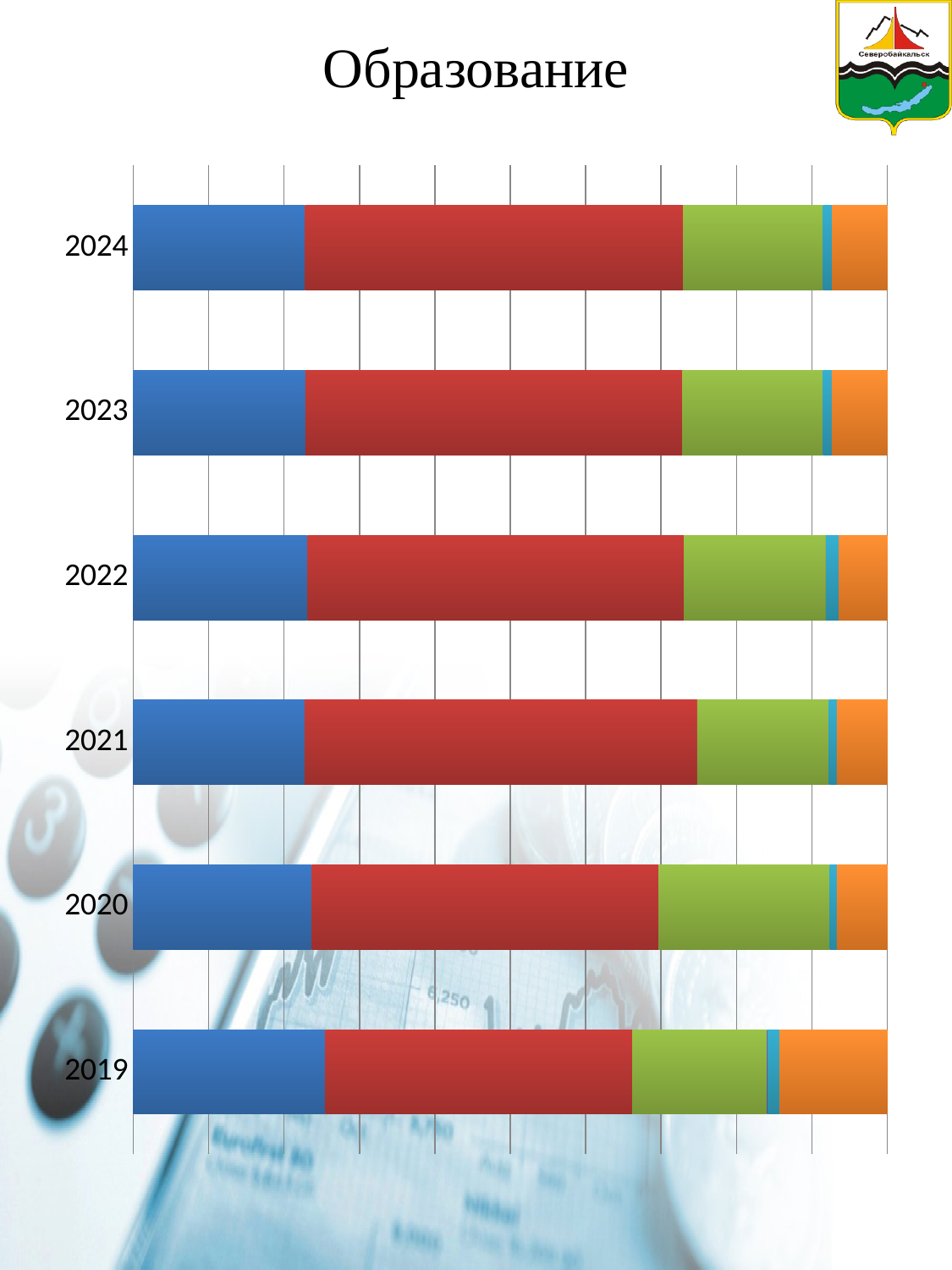
Which year is listed at the bottom of the chart? 2019 How many coloured segments make up each bar in the chart? 5 Does the orange segment get larger or smaller going from 2019 to 2024? Smaller Which year has the shortest red segment? 2019 Is the blue segment larger for 2019 or for 2024? 2019 How many years (categories) are shown on the chart? 6 Is the red segment larger for 2019 or for 2023? 2023 Which year is listed at the top of the chart? 2024 Which year has the largest orange segment? 2019 Is the orange segment larger for 2019 or for 2024? 2019 What is the title of the slide with the chart? Образование What kind of chart is shown on the slide? Stacked bar chart